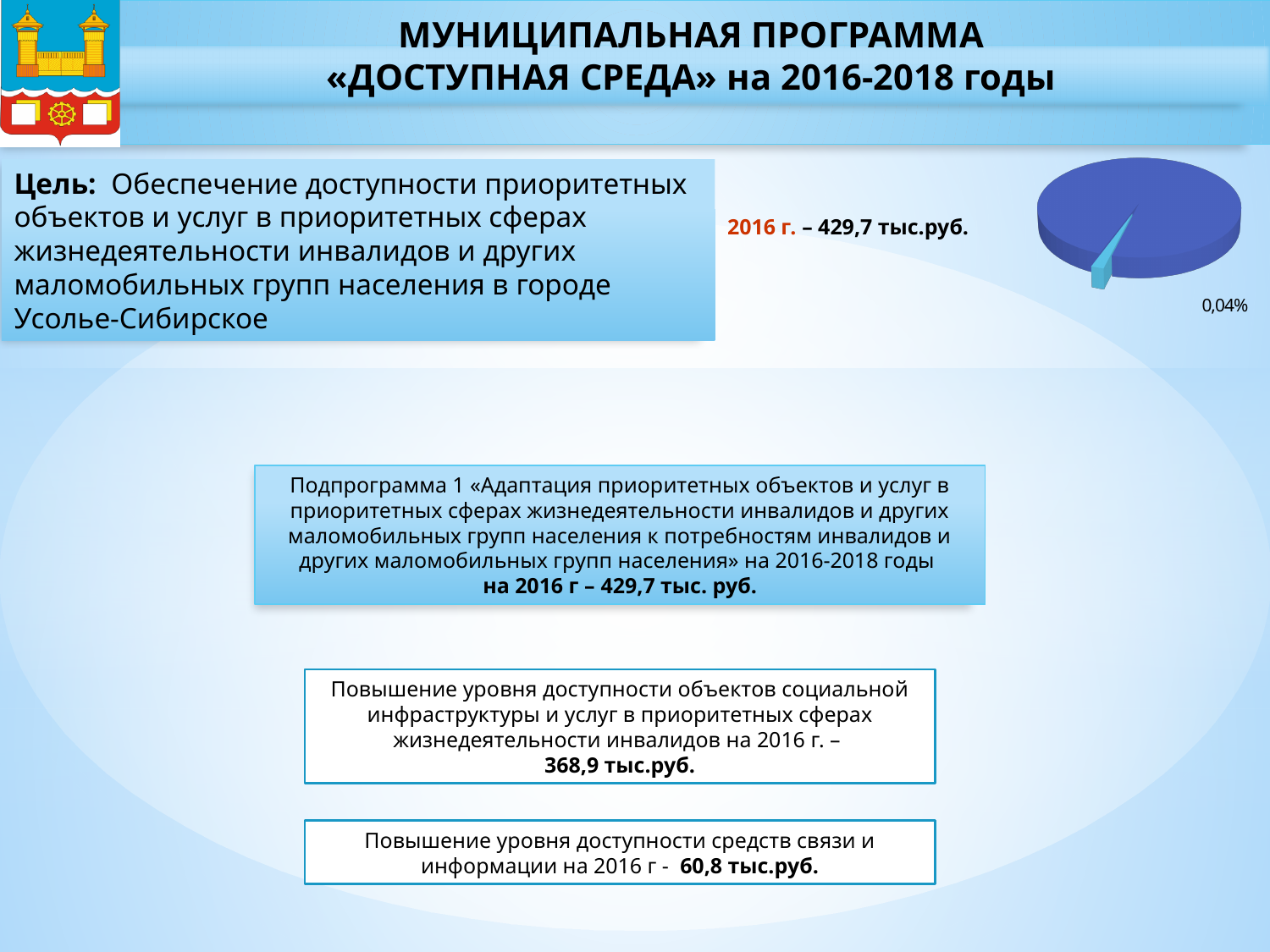
What percentage label is printed next to the small slice of the pie chart? 0,04% How many slices does the pie chart show? 2 What kind of chart is shown on the right side of the slide? pie chart Which slice of the pie chart is larger, the dark blue one or the light blue one? the dark blue one Does the pie chart have a legend? No What colour is the large slice of the pie chart? blue